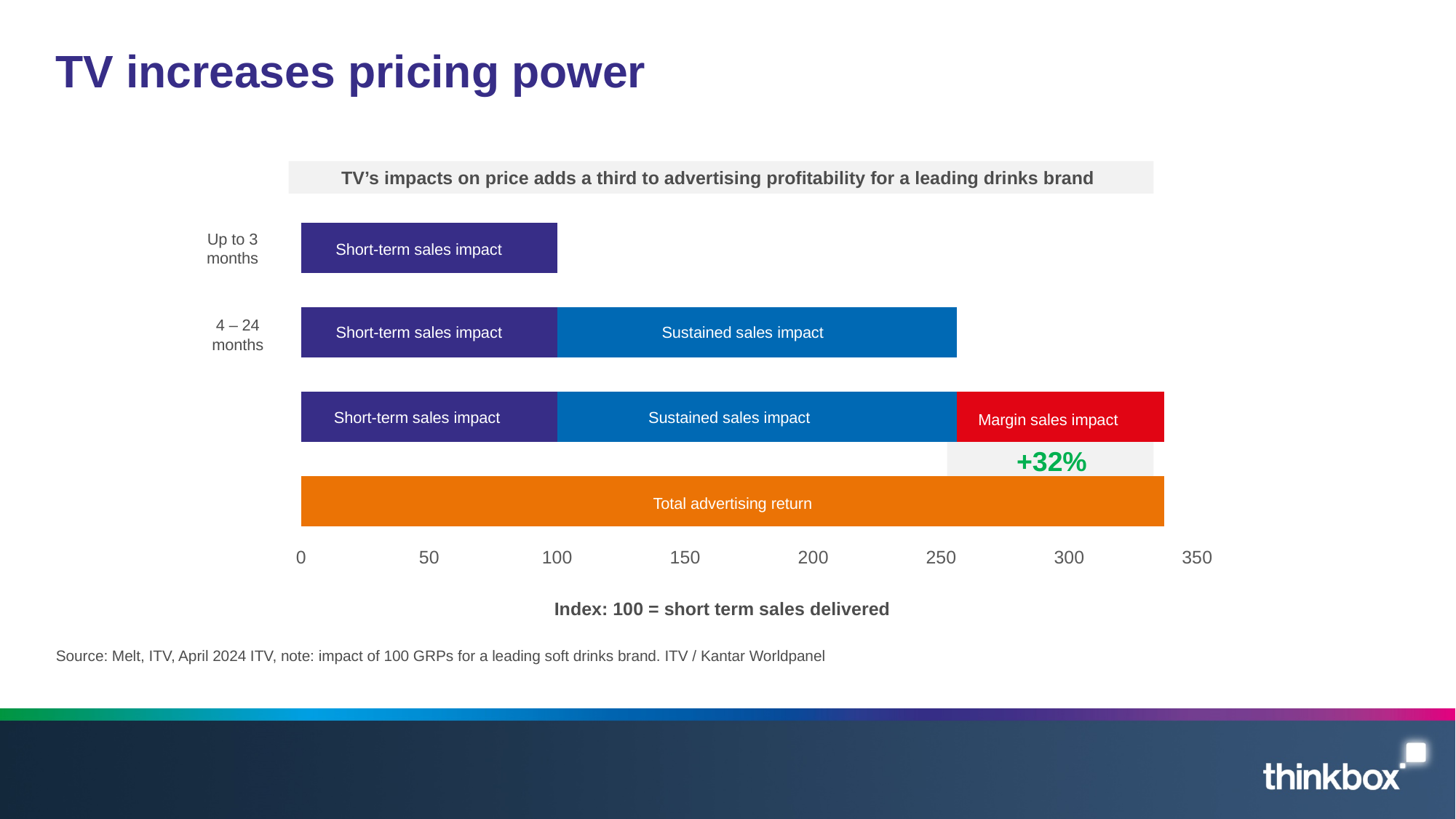
Which is longer: the 'Up to 3 months' bar or the '4 – 24 months' bar? 4 – 24 months Which bar is the shortest in the chart? Up to 3 months Is the Total advertising return bar greater or less than 300? greater What does the index note below the axis say 100 equals? short term sales delivered What kind of chart is shown on the slide? bar chart What value does the Short-term sales impact bar for 'Up to 3 months' reach on the axis? 100 Is the total length of the '4 – 24 months' bar greater or less than 300? less What percentage label is shown next to the Margin sales impact segment? +32% Is the Total advertising return bar greater or less than 350? less What is the title shown above the chart? TV's impacts on price adds a third to advertising profitability for a leading drinks brand